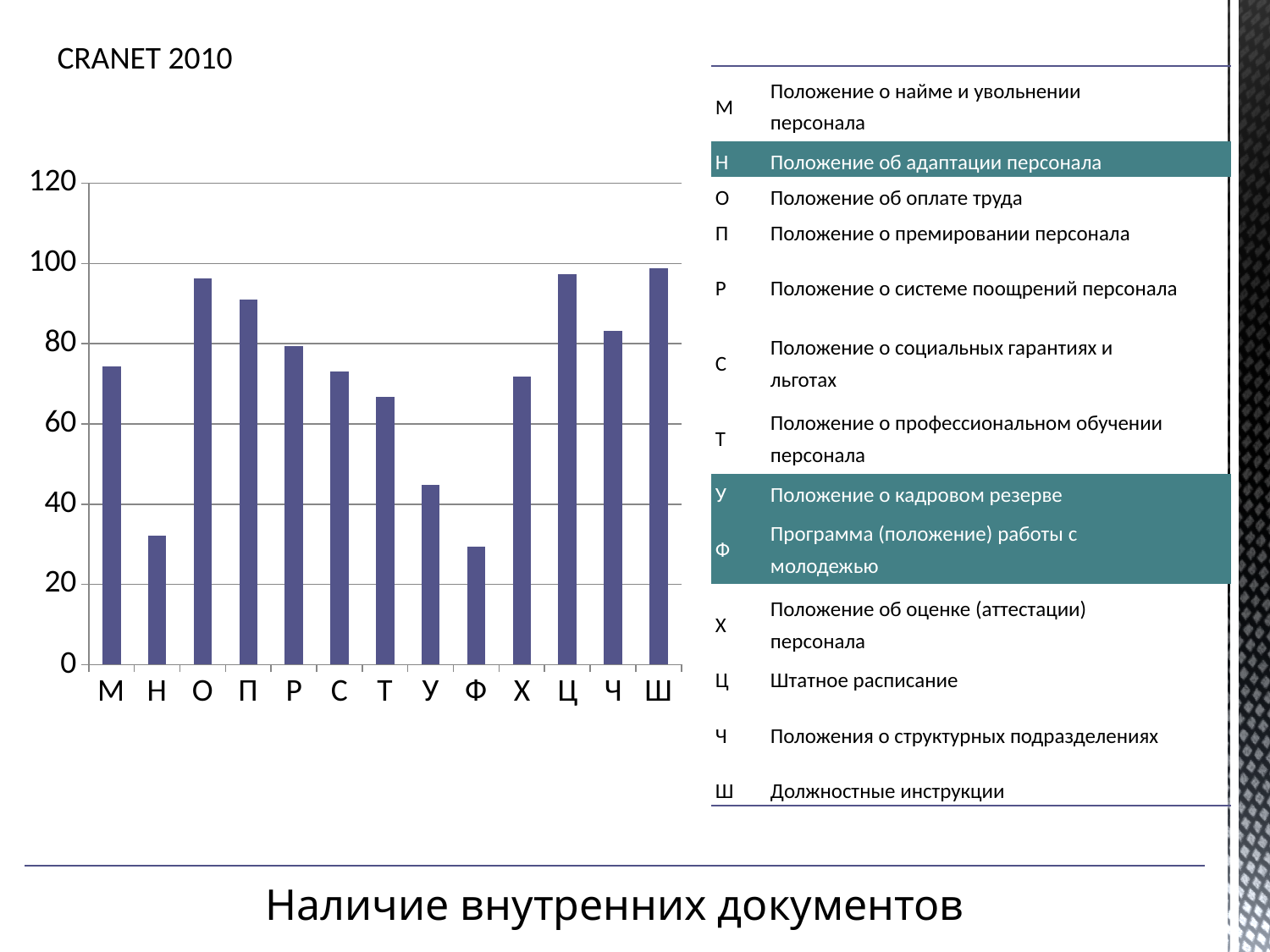
Is the value for Х greater or less than 60? greater What kind of chart is shown on the slide? bar chart Is the value for Ф greater or less than 40? less How many categories (bars) are plotted on the chart? 13 According to the table on the slide, what document does the category Ш stand for? Должностные инструкции What is the highest value shown on the vertical axis? 120 Which has the larger value, О or Н? О Is the value for Т greater or less than 60? greater Which has the larger value, У or Ц? Ц